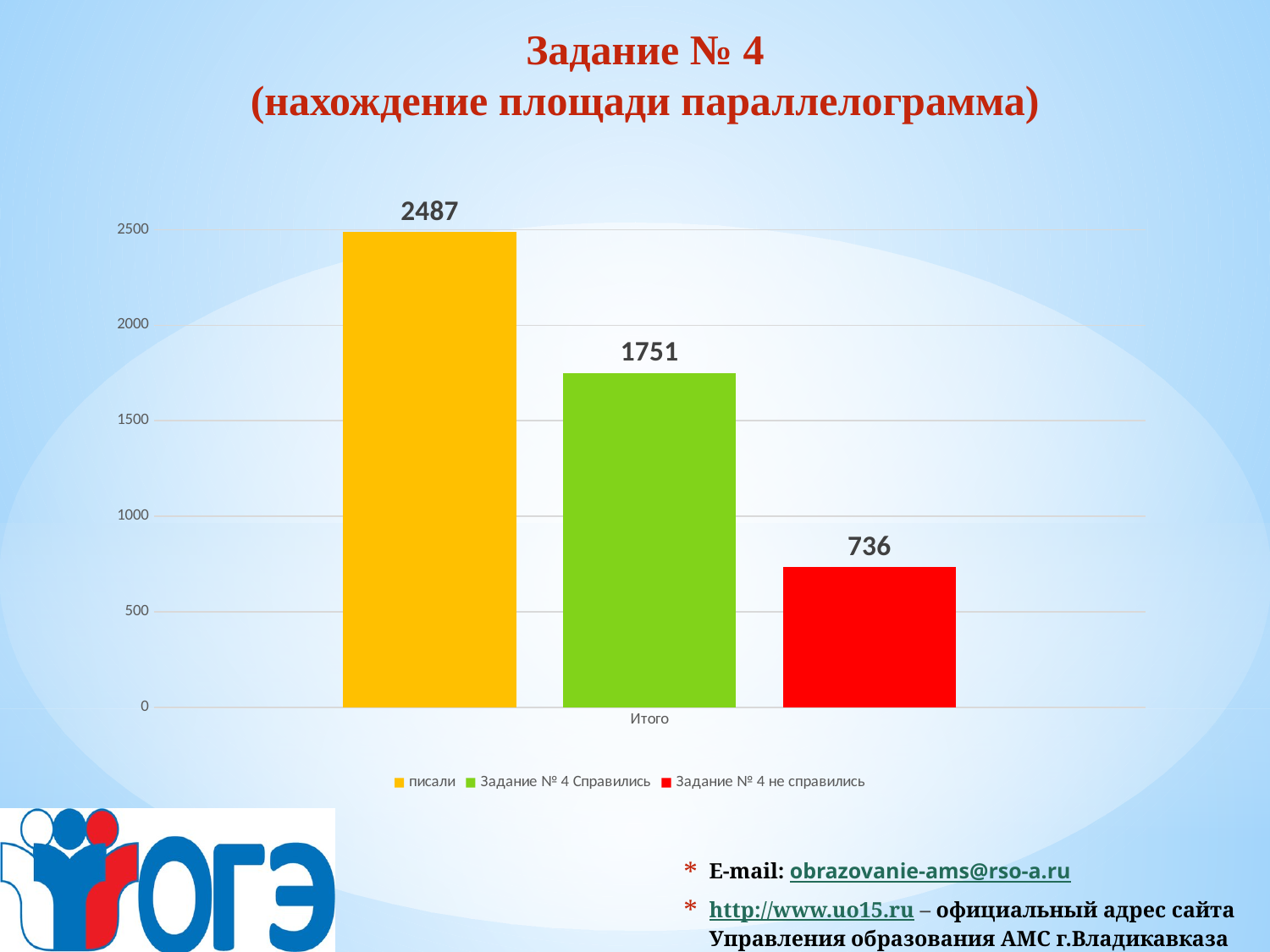
What value is shown for "Задание № 4 не справились"? 736 What colour is the bar for "Задание № 4 не справились"? red What kind of chart is shown on the slide? bar chart What is the difference between "писали" and "Задание № 4 Справились"? 736 Is the value for "Задание № 4 не справились" greater or less than 1000? less What is the difference between "Задание № 4 Справились" and "Задание № 4 не справились"? 1015 What value is shown for the series "писали"? 2487 How many series does the legend list? 3 Which is larger: "Задание № 4 Справились" or "Задание № 4 не справились"? Задание № 4 Справились What value is shown for "Задание № 4 Справились"? 1751 Which series has the highest value? писали Which series has the lowest value? Задание № 4 не справились